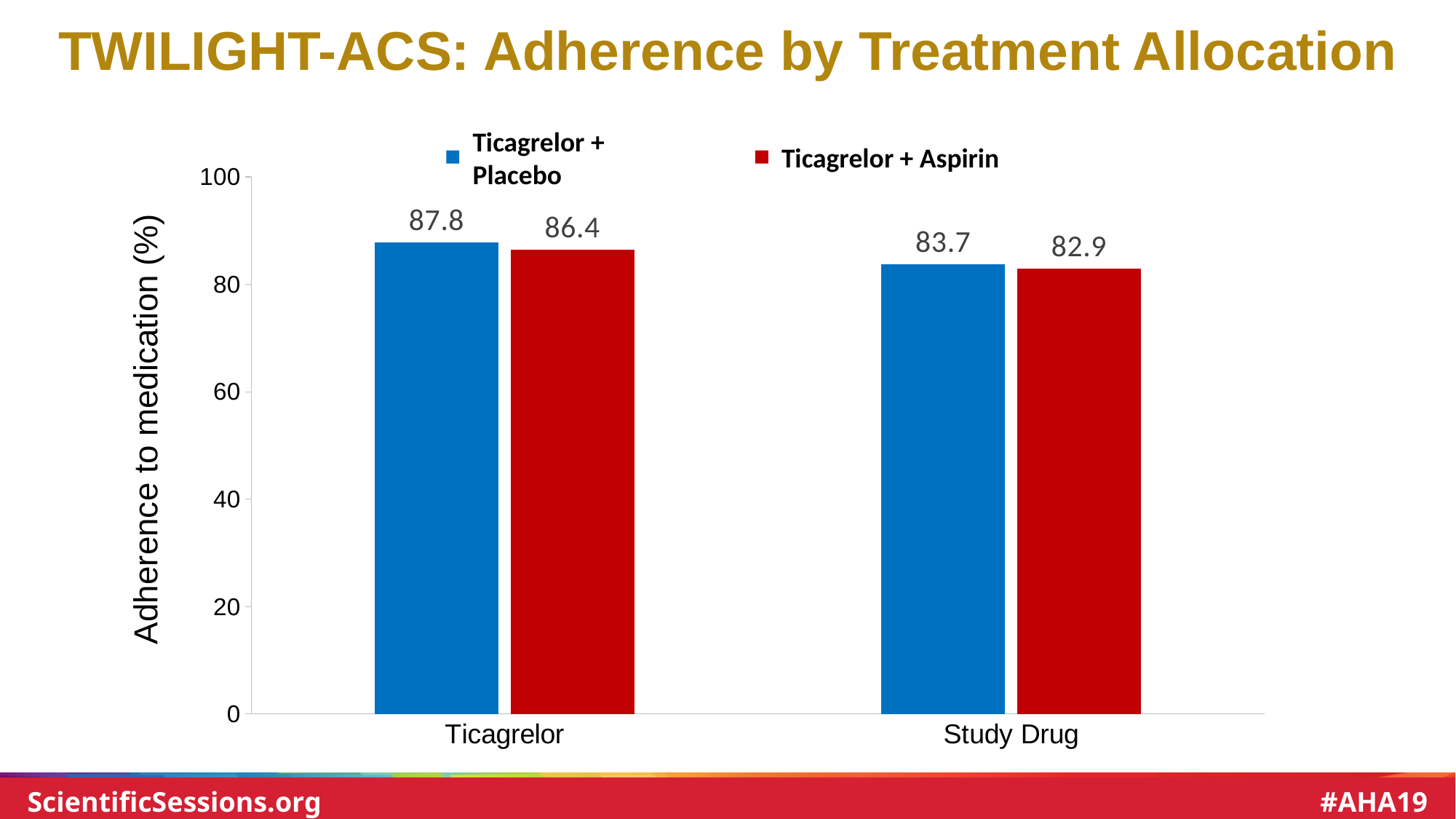
What is the adherence to medication for Ticagrelor + Placebo in the Study Drug category? 83.7 What is the adherence to medication for Ticagrelor + Aspirin in the Study Drug category? 82.9 Which category has the highest adherence value for Ticagrelor + Placebo? Ticagrelor Which category has the lowest adherence value for Ticagrelor + Aspirin? Study Drug What is the adherence to medication for Ticagrelor + Aspirin in the Ticagrelor category? 86.4 What is the difference between the Ticagrelor + Placebo value for Ticagrelor and for Study Drug? 4.1 How many series does the legend list? 2 How many categories are shown on the x axis? 2 What is the label of the y axis? Adherence to medication (%) What is the adherence to medication for Ticagrelor + Placebo in the Ticagrelor category? 87.8 What is the difference between the Ticagrelor + Placebo and Ticagrelor + Aspirin values in the Ticagrelor category? 1.4 What kind of chart is shown on the slide? Bar chart